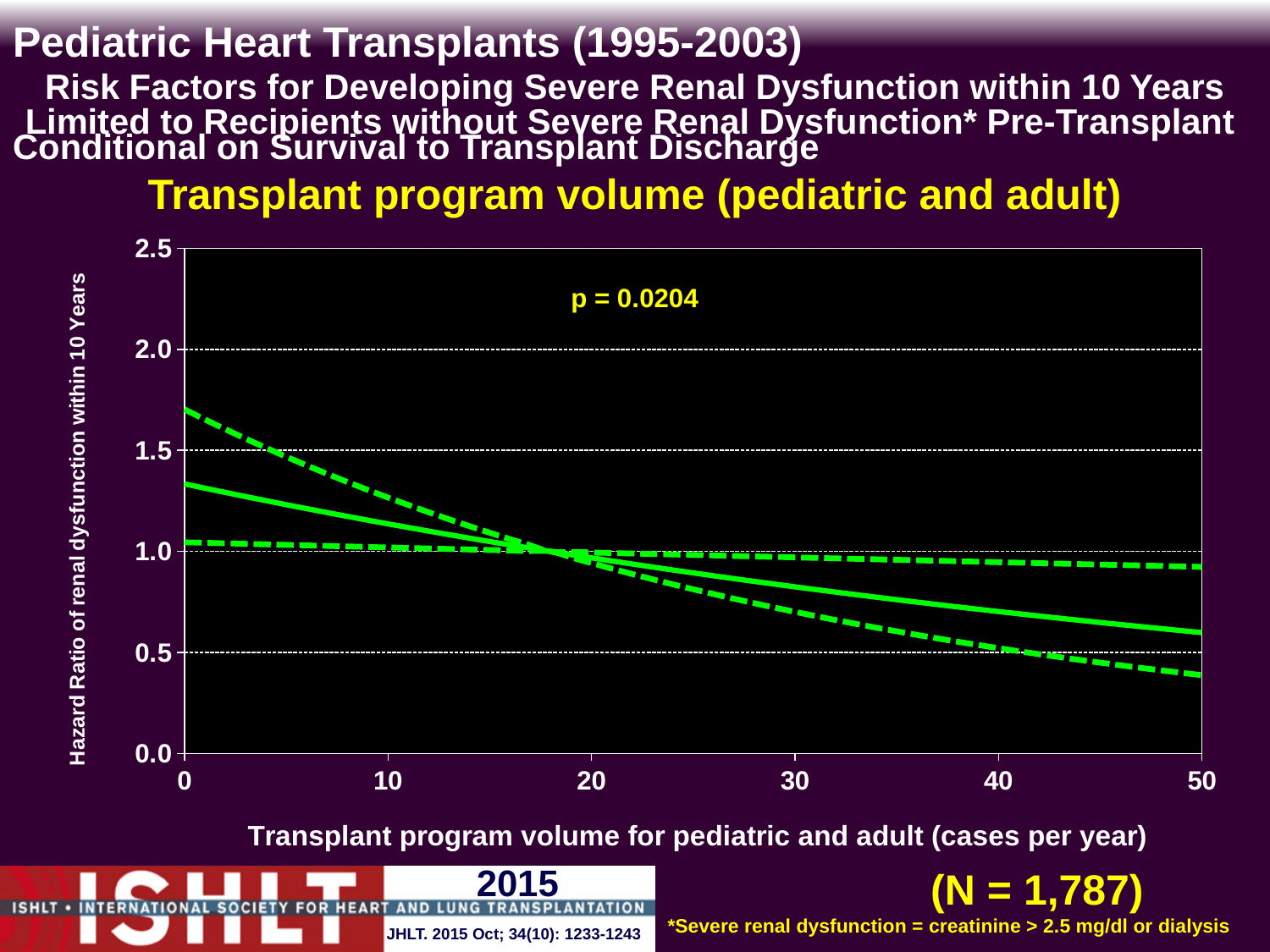
Is the value of the solid line at a transplant program volume of 50 cases per year greater or less than 1.0? less What kind of chart is shown on the slide? line chart Is the value of the solid line at a transplant program volume of 30 cases per year greater or less than 1.0? less Is the value of the lower dashed line at a transplant program volume of 50 cases per year greater or less than 0.5? less Does the solid line (hazard ratio) rise or fall as transplant program volume increases along the x axis? fall What p-value is printed on the chart? p = 0.0204 What is the label of the x axis? Transplant program volume for pediatric and adult (cases per year) How many lines are plotted on the chart? 3